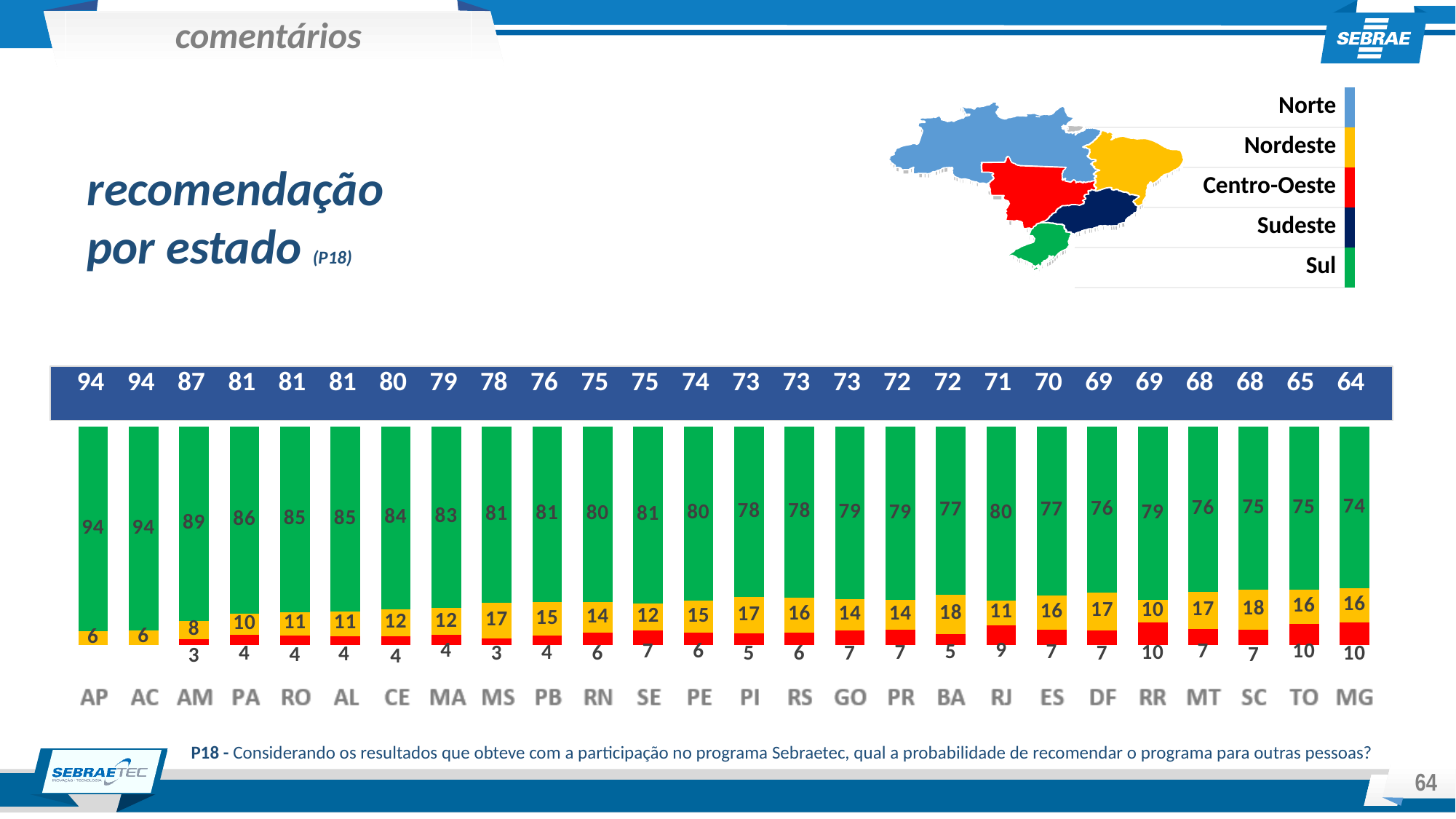
How many states (categories) are shown along the x axis of the chart? 26 What is the difference between the header-row values for AP and MG? 30 Which state has the lowest value in the blue header row above the bars? MG What is the value of the red segment for RR? 10 What is the value of the yellow segment for BA? 18 What is the value of the red segment for RJ? 9 How many regions are listed in the map legend at the top right of the slide? 5 What is the value of the green segment for AM? 89 Which has a larger green segment, CE or MG? CE What is the total of the three segments of the bar for AM? 100 What is the value shown in the blue header row above the bar for SC? 68 What kind of chart is shown on the slide? stacked bar chart